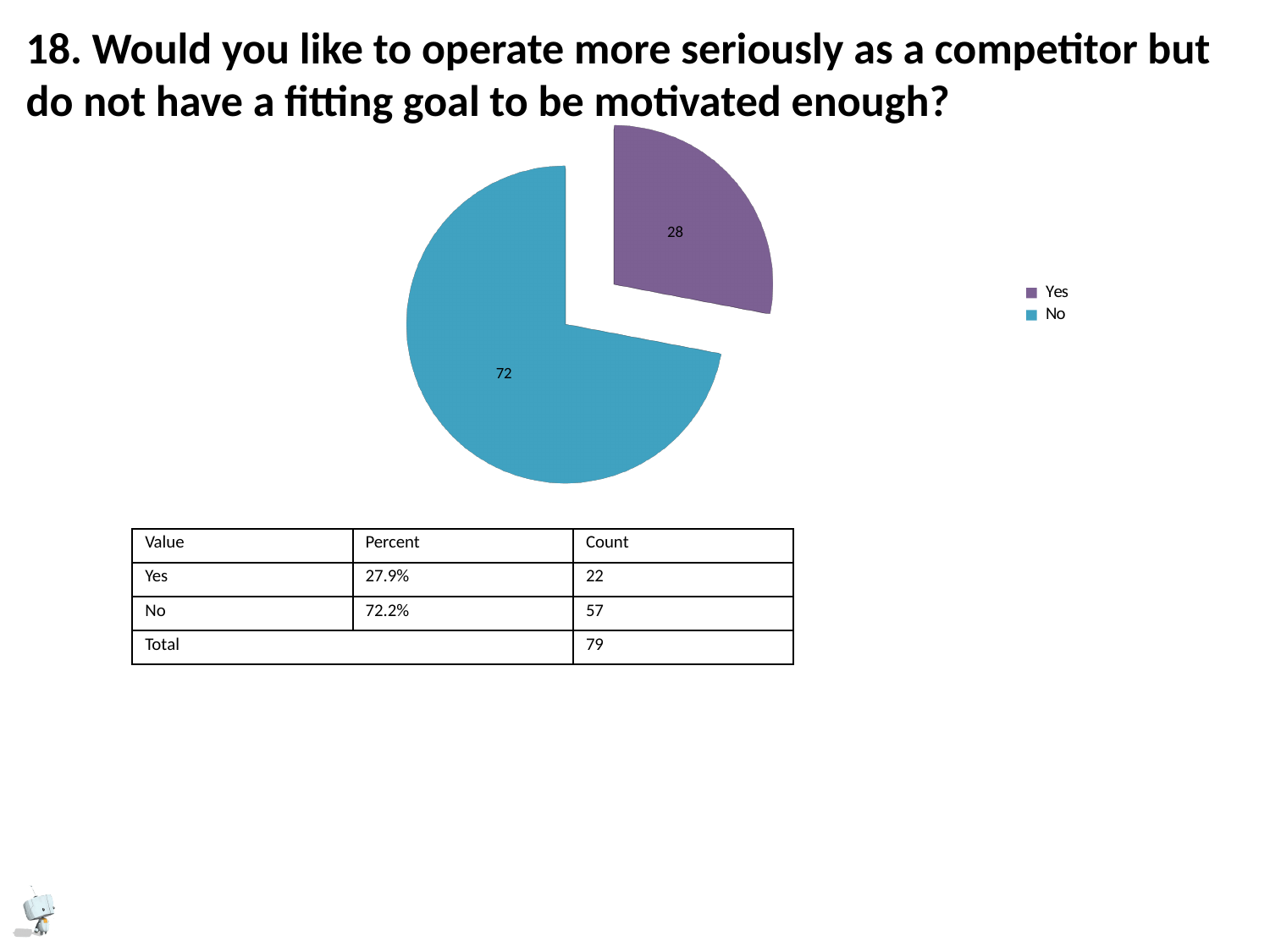
Which slice of the pie chart is the smallest? Yes How many slices does the pie chart have? 2 What is the data label on the Yes slice of the pie chart? 28 What share of the pie does the No slice represent, according to its data label? 72 How many entries does the legend of the pie chart list? 2 Which slice is larger in the pie chart, Yes or No? No What is the data label on the No slice of the pie chart? 72 Which slice of the pie chart is pulled out (exploded) from the rest? Yes What type of chart is shown on the slide? pie chart Which slice of the pie chart is the largest? No What is the difference between the data labels of the No slice and the Yes slice? 44 What colour is the Yes slice in the pie chart? purple